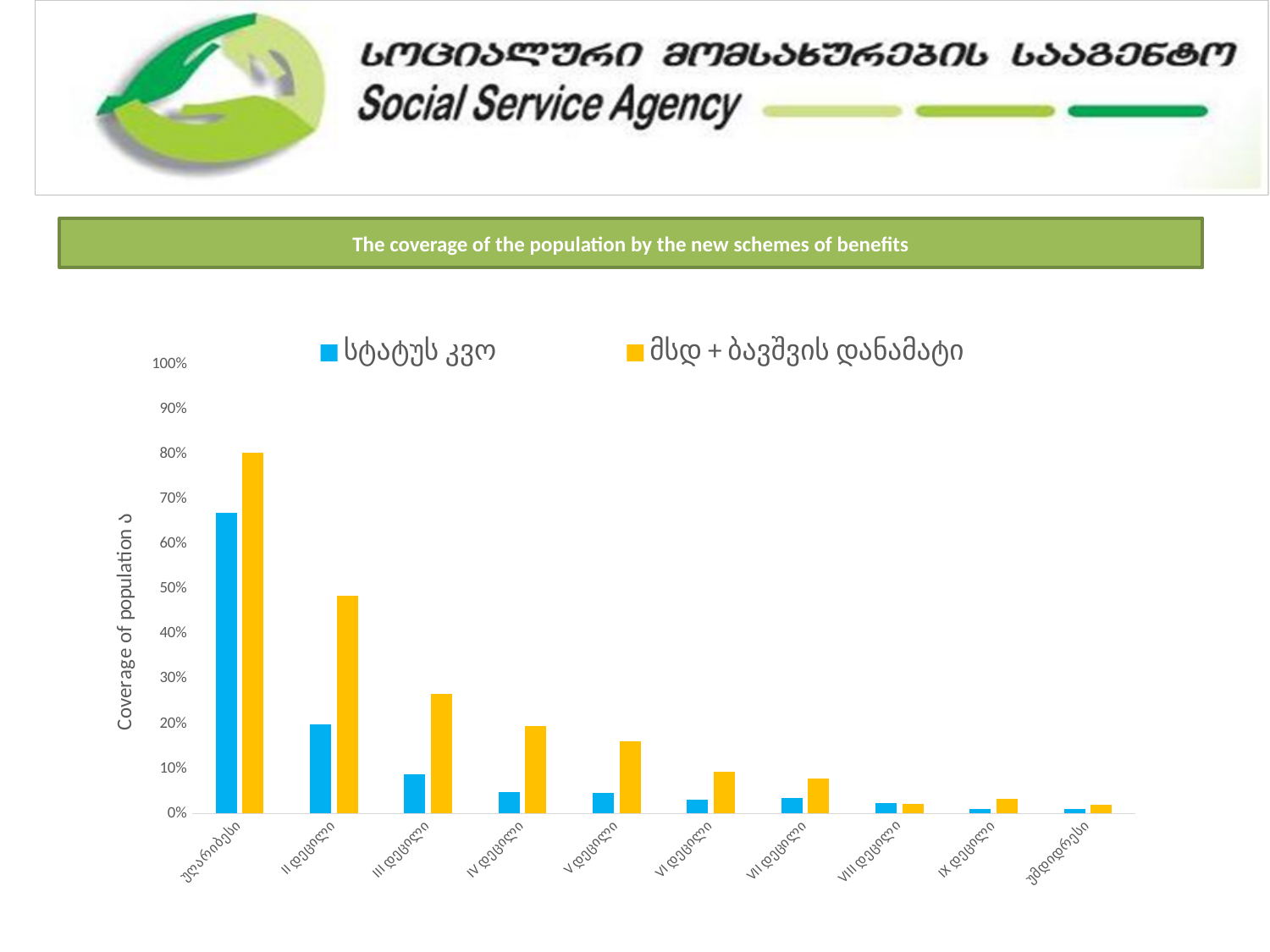
Do the values generally rise or fall moving from left to right along the x axis? fall Is the yellow (მსდ + ბავშვის დანამატი) value for III დეცილი greater or less than 30%? less What kind of chart is shown on the slide? bar chart For the first category, უღარიბესი, which series has the larger value? მსდ + ბავშვის დანამატი (yellow) Is the blue (სტატუს კვო) value for II დეცილი greater or less than 30%? less How many categories are shown along the x axis? 10 What is the title shown above the chart? The coverage of the population by the new schemes of benefits Is the blue (სტატუს კვო) value for the first category, უღარიბესი, greater or less than 60%? greater Which category has the highest value for the blue series (სტატუს კვო)? უღარიბესი (the first category) Which category has the highest value for the yellow series (მსდ + ბავშვის დანამატი)? უღარიბესი (the first category) How many series does the legend list? 2